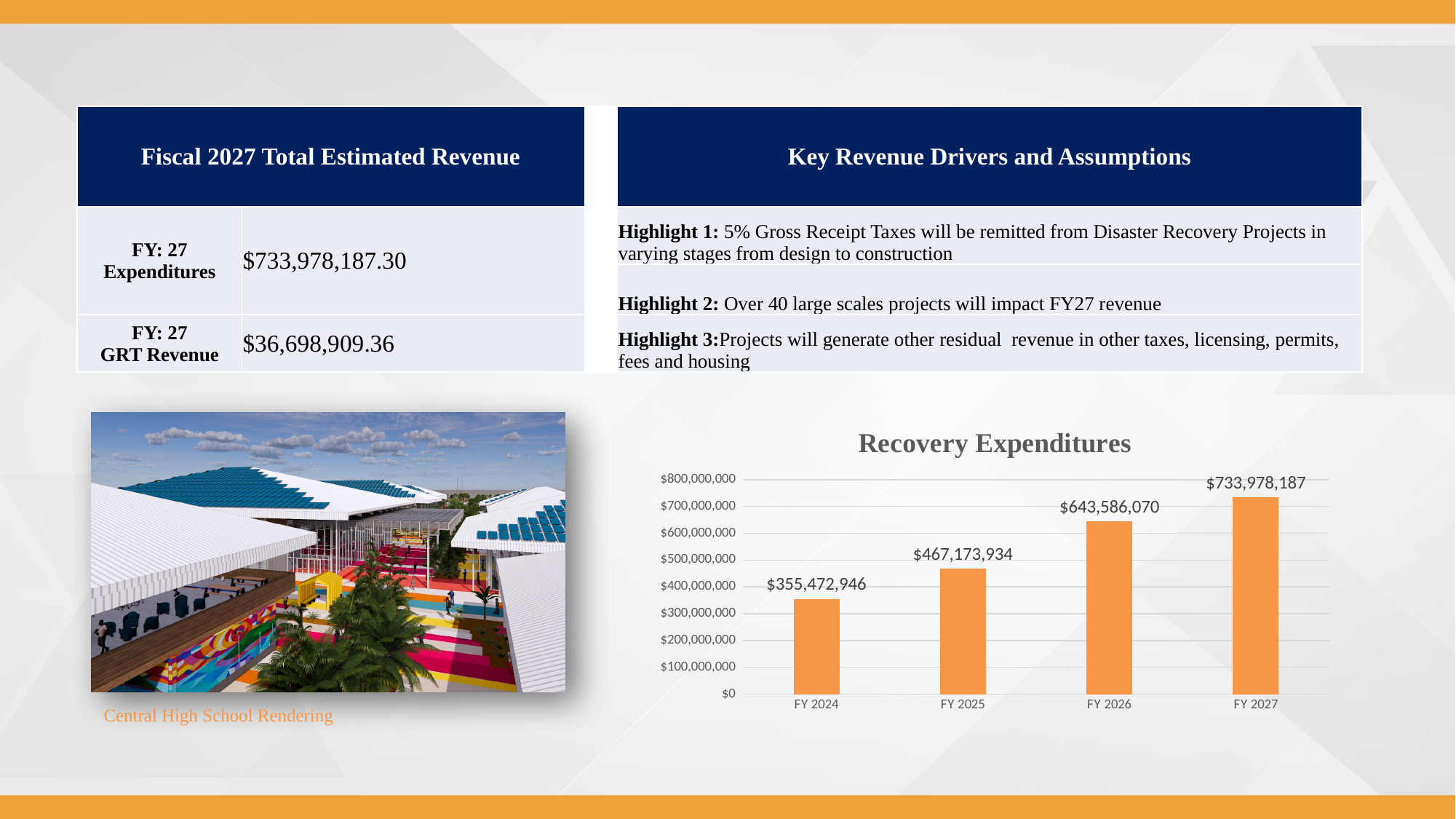
What is the value for FY 2026 in the Recovery Expenditures chart? $643,586,070 What is the value for FY 2025 in the Recovery Expenditures chart? $467,173,934 What is the value for FY 2024 in the Recovery Expenditures chart? $355,472,946 What kind of chart is the Recovery Expenditures chart? Bar chart Which fiscal year has the highest recovery expenditures in the chart? FY 2027 What is the value for FY 2027 in the Recovery Expenditures chart? $733,978,187 In the Recovery Expenditures chart, which is larger, the value for FY 2025 or the value for FY 2026? FY 2026 Do the values in the Recovery Expenditures chart rise or fall from FY 2024 to FY 2027? Rise Which fiscal year has the lowest recovery expenditures in the chart? FY 2024 What is the difference between the FY 2027 and FY 2026 values in the Recovery Expenditures chart? $90,392,117 How many fiscal years are shown in the Recovery Expenditures chart? 4 What is the difference between the FY 2025 and FY 2024 values in the Recovery Expenditures chart? $111,700,988